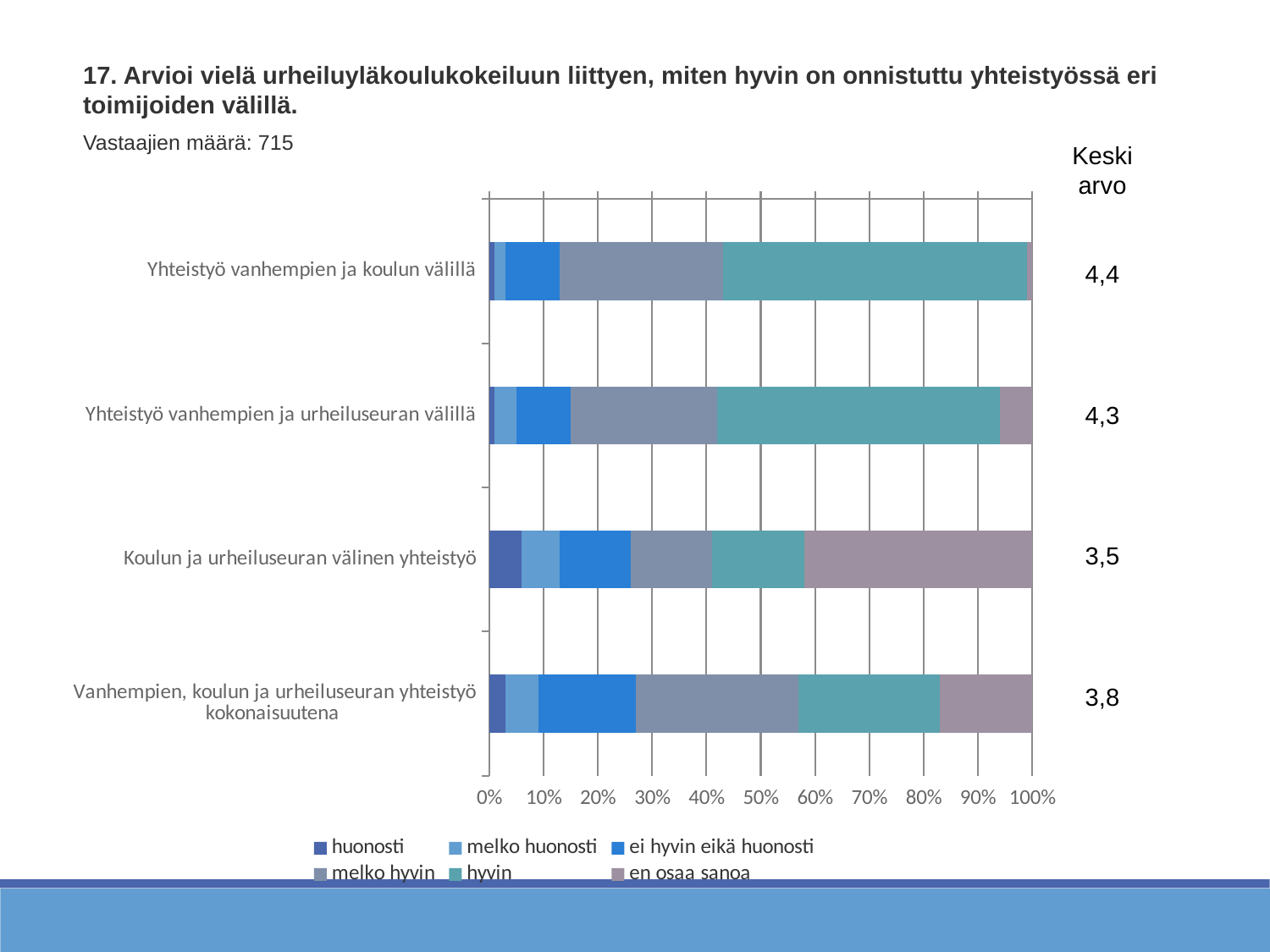
What kind of chart is shown on the slide? Stacked bar chart Which category has the lowest Keskiarvo value? Koulun ja urheiluseuran välinen yhteistyö Which category has the highest Keskiarvo value? Yhteistyö vanhempien ja koulun välillä How many series does the legend list? 6 Which category has the largest 'en osaa sanoa' segment? Koulun ja urheiluseuran välinen yhteistyö What is the difference between the Keskiarvo values of 'Yhteistyö vanhempien ja koulun välillä' and 'Koulun ja urheiluseuran välinen yhteistyö'? 0,9 What is the Keskiarvo value shown for 'Koulun ja urheiluseuran välinen yhteistyö'? 3,5 What is the Keskiarvo value shown for 'Vanhempien, koulun ja urheiluseuran yhteistyö kokonaisuutena'? 3,8 Is the 'hyvin' segment for 'Yhteistyö vanhempien ja koulun välillä' greater or less than 50% of the bar? greater How many respondents (Vastaajien määrä) are reported on the slide? 715 What is the Keskiarvo (mean) value shown for 'Yhteistyö vanhempien ja koulun välillä'? 4,4 How many categories (bars) does the chart show? 4